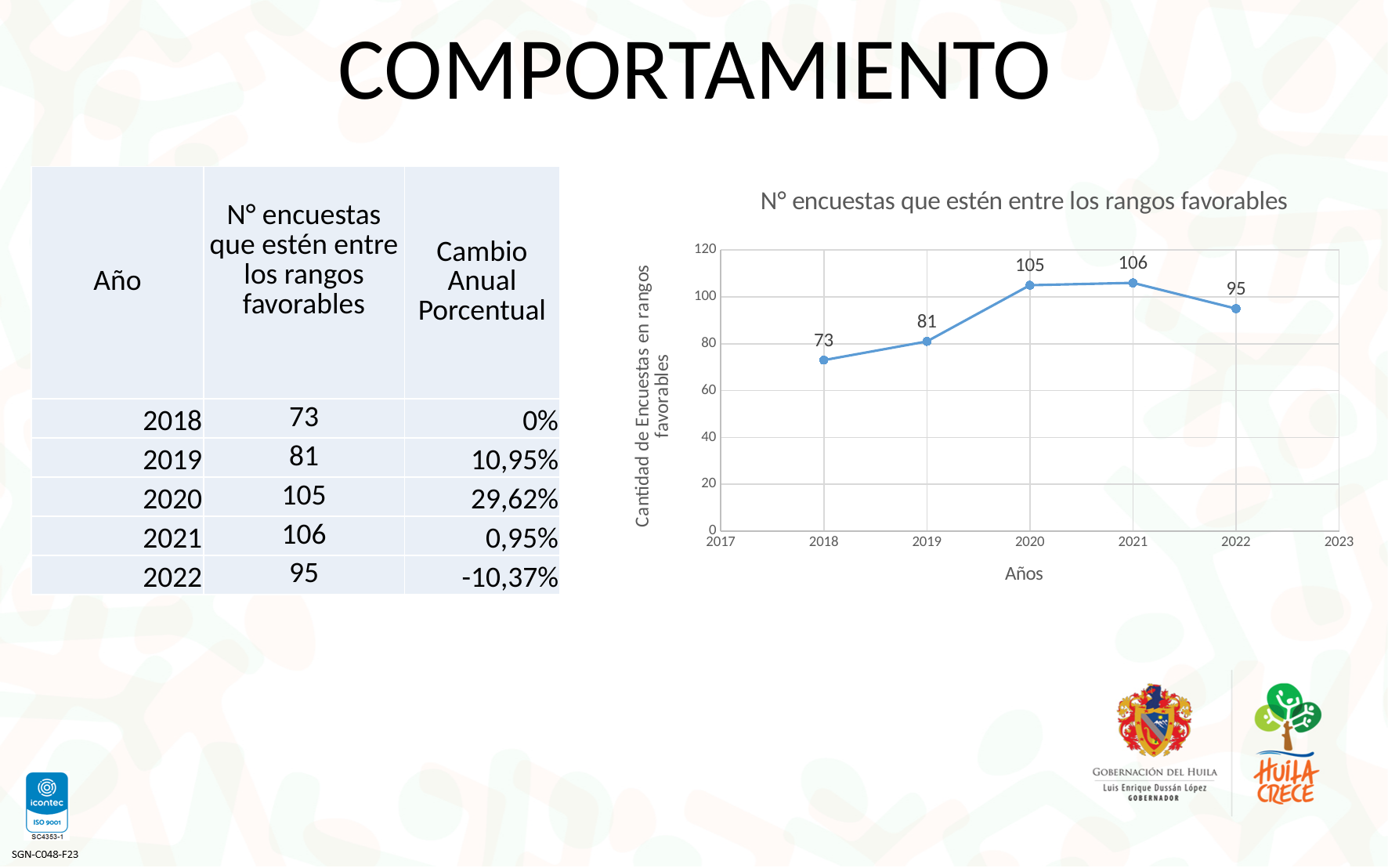
Which is larger, the value for 2019 or the value for 2022? 2022 What is the value for 2018 in the chart? 73 What is the difference between the values for 2021 and 2022? 11 What is the value for 2020 in the chart? 105 Which year has the highest value in the chart? 2021 What is the title of the chart? N° encuestas que estén entre los rangos favorables How many data points are plotted in the chart? 5 Is the value for 2019 greater or less than 100? less Which year has the lowest value in the chart? 2018 What is the difference between the values for 2020 and 2019? 24 What is the value for 2022 in the chart? 95 What kind of chart is shown on the slide? line chart